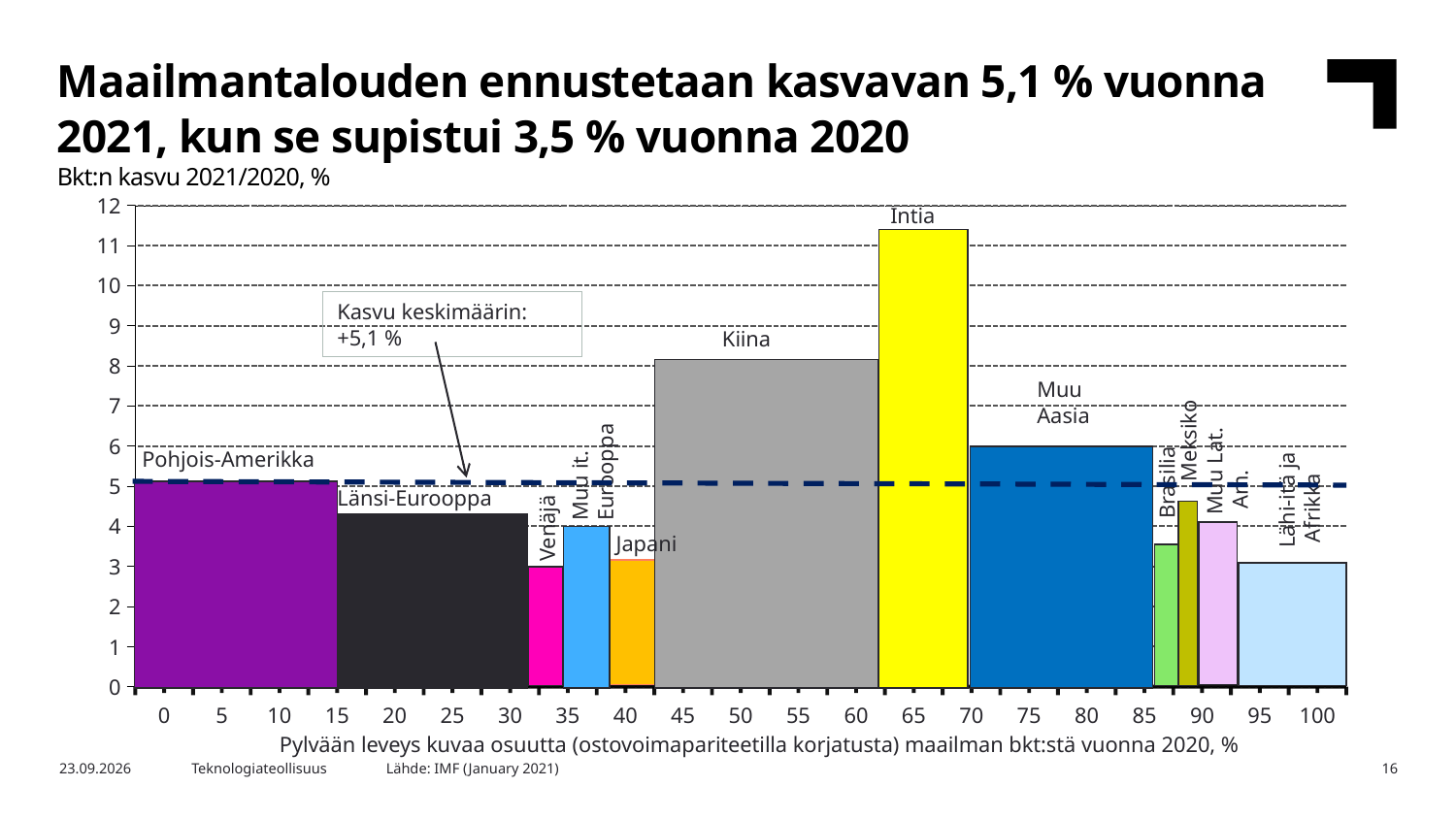
Which has the larger value, Kiina or Intia? Intia Which has the larger value, Pohjois-Amerikka or Länsi-Eurooppa? Pohjois-Amerikka Is the value for Venäjä greater or less than 4? less Is the value for Intia greater or less than 11? greater What average growth value is shown in the annotation box on the chart? +5,1 % What kind of chart is shown on the slide? bar chart Which region has the highest GDP growth in the chart? Intia Is the value for Länsi-Eurooppa greater or less than 5? less Which has the larger value, Kiina or Muu Aasia? Kiina What is the y-axis label of the chart? Bkt:n kasvu 2021/2020, % How many regions (bars) are shown in the chart? 12